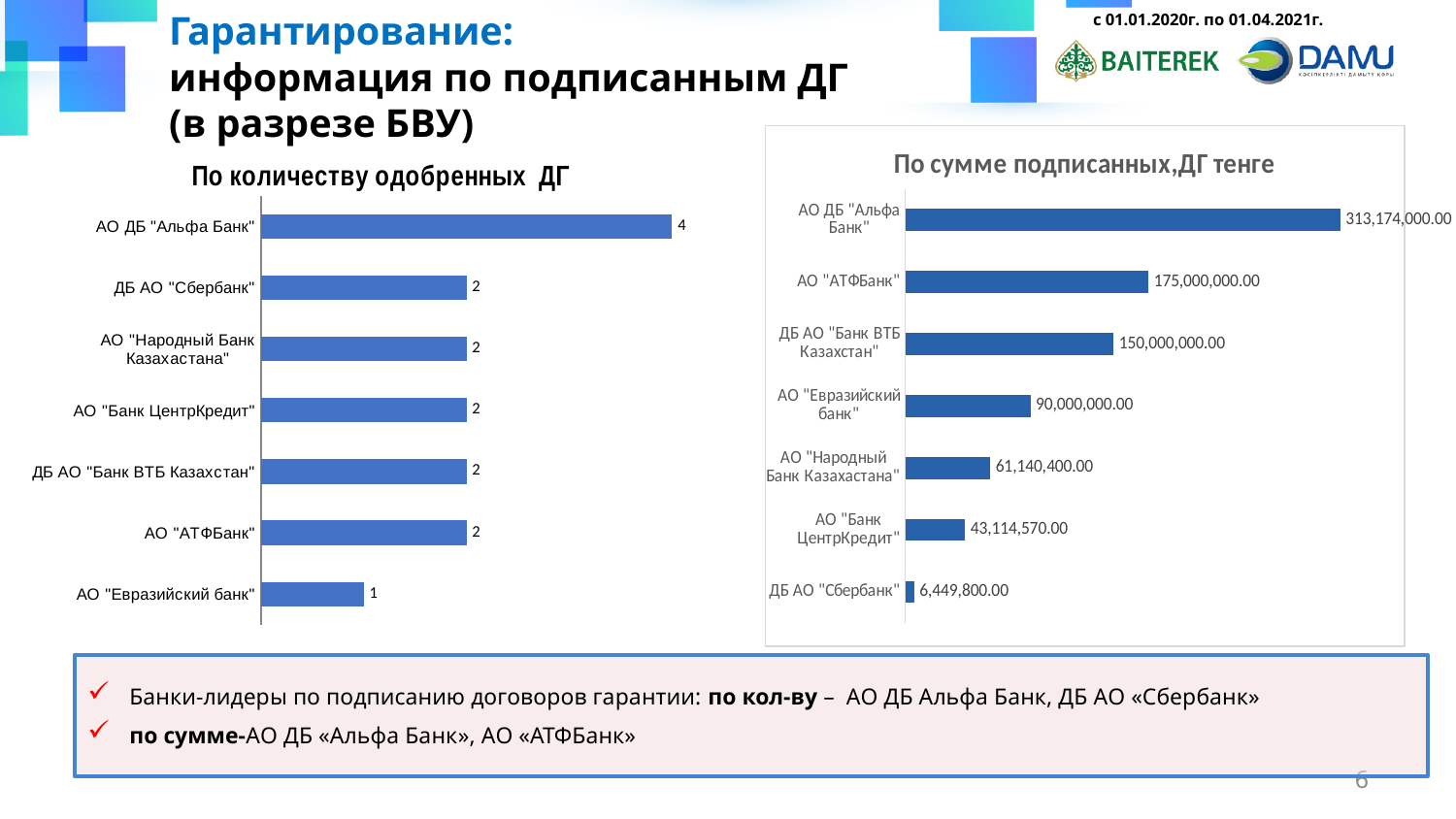
In the chart "По сумме подписанных,ДГ тенге", what is the difference between АО "АТФБанк" and ДБ АО "Банк ВТБ Казахстан"? 25,000,000.00 In the chart "По сумме подписанных,ДГ тенге", which bank has the highest value? АО ДБ "Альфа Банк" What type of chart is "По сумме подписанных,ДГ тенге"? Bar chart In the chart "По сумме подписанных,ДГ тенге", what is the value for АО "АТФБанк"? 175,000,000.00 In the chart "По количеству одобренных ДГ", what is the value for АО ДБ "Альфа Банк"? 4 In the chart "По сумме подписанных,ДГ тенге", which is larger: the value for АО "Евразийский банк" or АО "Народный Банк Казахстана"? АО "Евразийский банк" What is the title of the chart on the left side of the slide? По количеству одобренных ДГ In the chart "По количеству одобренных ДГ", what is the difference between АО ДБ "Альфа Банк" and АО "Евразийский банк"? 3 In the chart "По сумме подписанных,ДГ тенге", what is the value for ДБ АО "Сбербанк"? 6,449,800.00 In the chart "По количеству одобренных ДГ", which bank has the lowest value? АО "Евразийский банк" In the chart "По сумме подписанных,ДГ тенге", which bank has the lowest value? ДБ АО "Сбербанк" In the chart "По количеству одобренных ДГ", how many banks are shown? 7